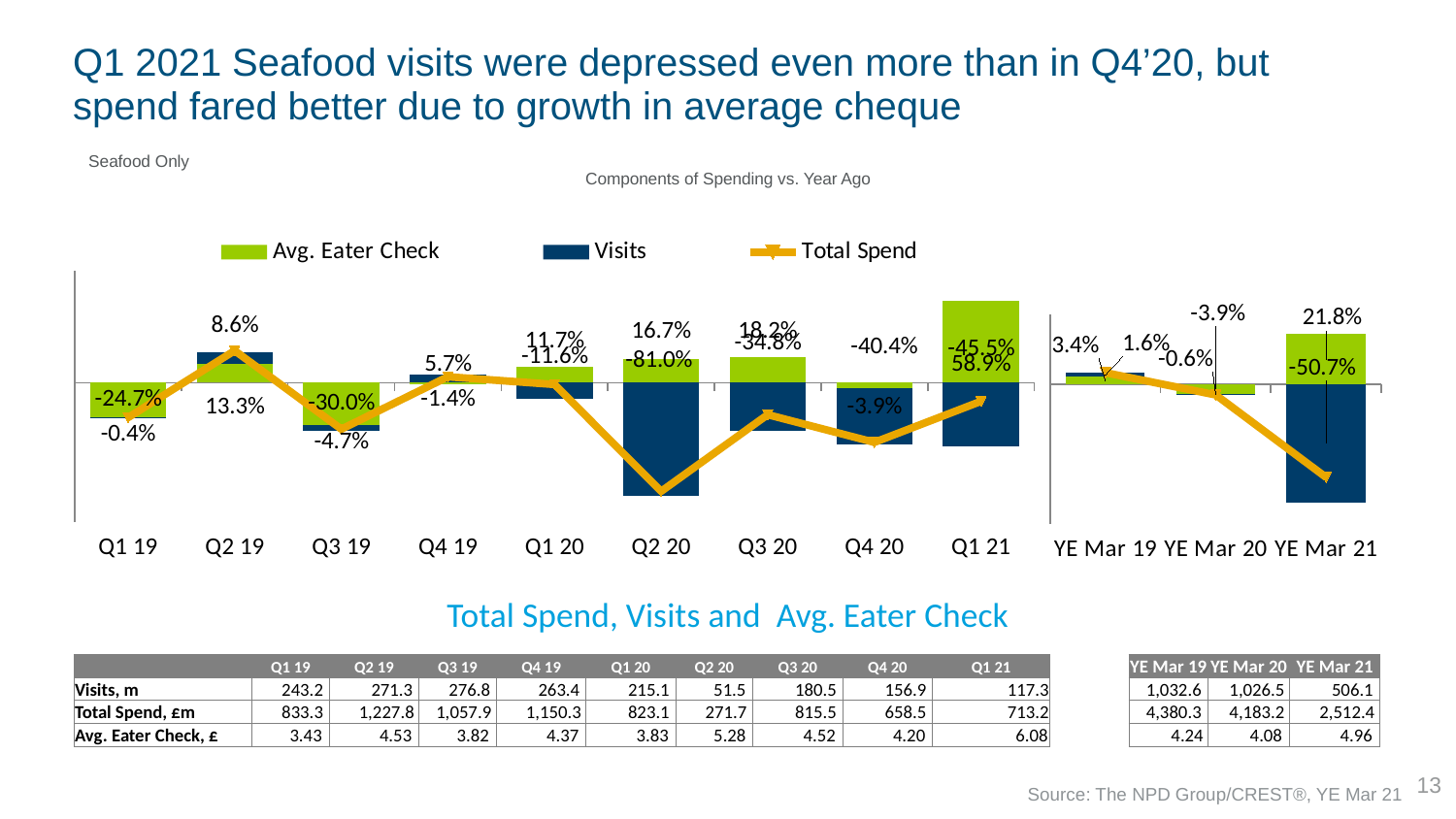
In the left chart, what is the Visits value for Q2 20? -81.0% In the table, what is Total Spend, £m for Q2 19? 1,227.8 In the table, what is Visits, m for Q1 21? 117.3 In the table, which quarter has the highest Avg. Eater Check, £? Q1 21 How many quarterly categories are shown on the left chart's x axis? 9 In the right chart, does the Total Spend line rise or fall from YE Mar 19 to YE Mar 21? Fall In the table, what is Visits, m for YE Mar 21? 506.1 In the table, what is the difference in Total Spend, £m between Q1 20 and Q1 21? 109.9 How many series does the chart legend list? 3 What kind of chart is used for the Components of Spending vs. Year Ago? Combined bar and line chart In the left chart, which quarter has the lowest Visits value? Q2 20 In the table, which is larger, Visits, m for Q3 20 or Q4 20? Q3 20